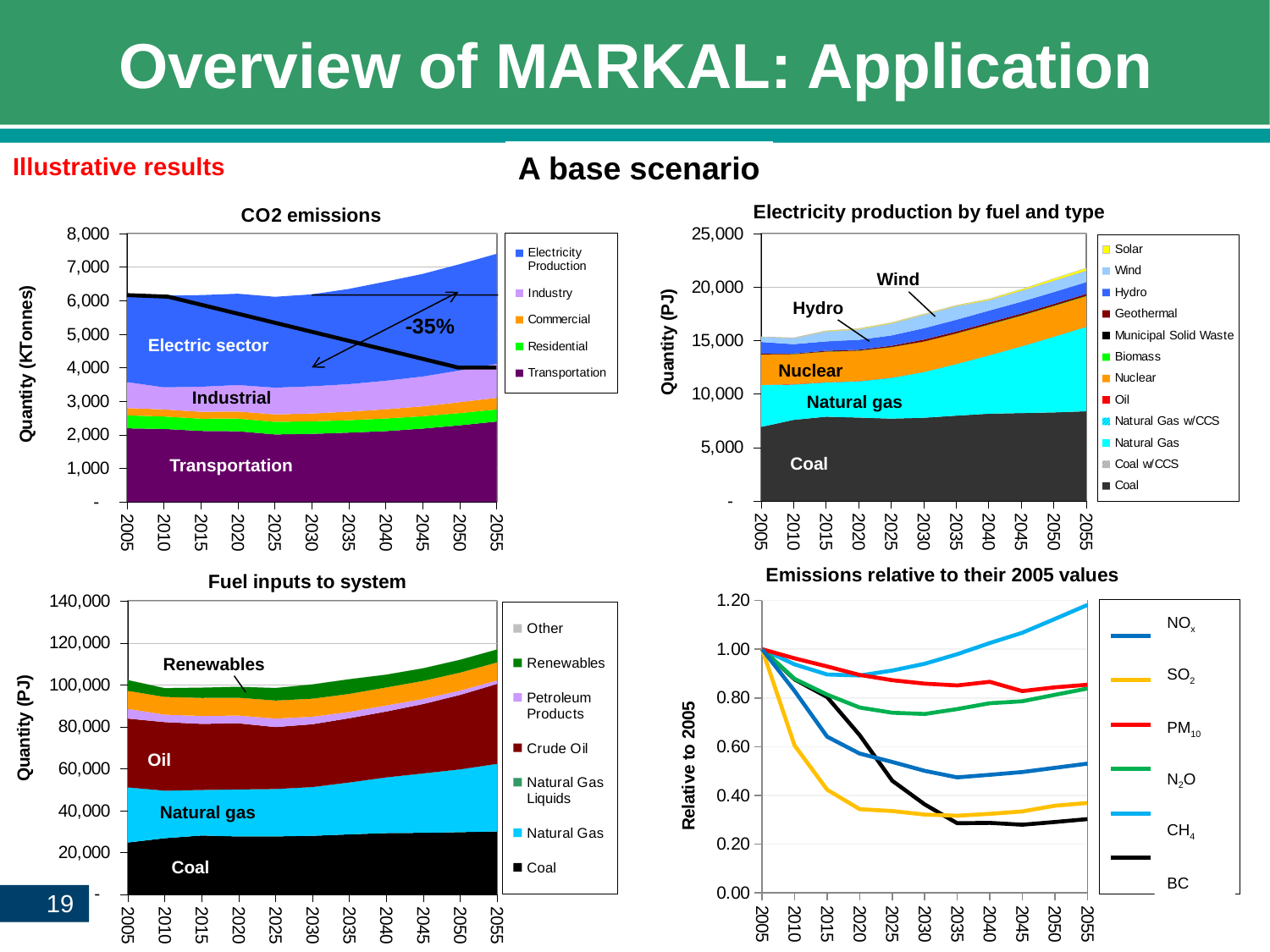
On the 'Emissions relative to their 2005 values' chart, how many series does the legend list? 6 On the 'Emissions relative to their 2005 values' chart, does the CH4 line rise or fall between 2020 and 2055? rise On the 'Fuel inputs to system' chart, how many series does the legend list? 7 On the 'Electricity production by fuel and type' chart, how many entries does the legend list? 12 What kind of chart is 'Emissions relative to their 2005 values'? Line chart On the 'CO2 emissions' chart, what percentage change is annotated on the chart? -35% On the 'Electricity production by fuel and type' chart, is the total electricity production in 2055 greater or less than 20,000? greater On the 'Fuel inputs to system' chart, how many year ticks are shown on the x axis? 11 On the 'Emissions relative to their 2005 values' chart, which series has the highest value in 2055? CH4 On the 'Emissions relative to their 2005 values' chart, which series has the lowest value in 2055? BC On the 'Emissions relative to their 2005 values' chart, is the SO2 value in 2035 greater or less than 0.40? less